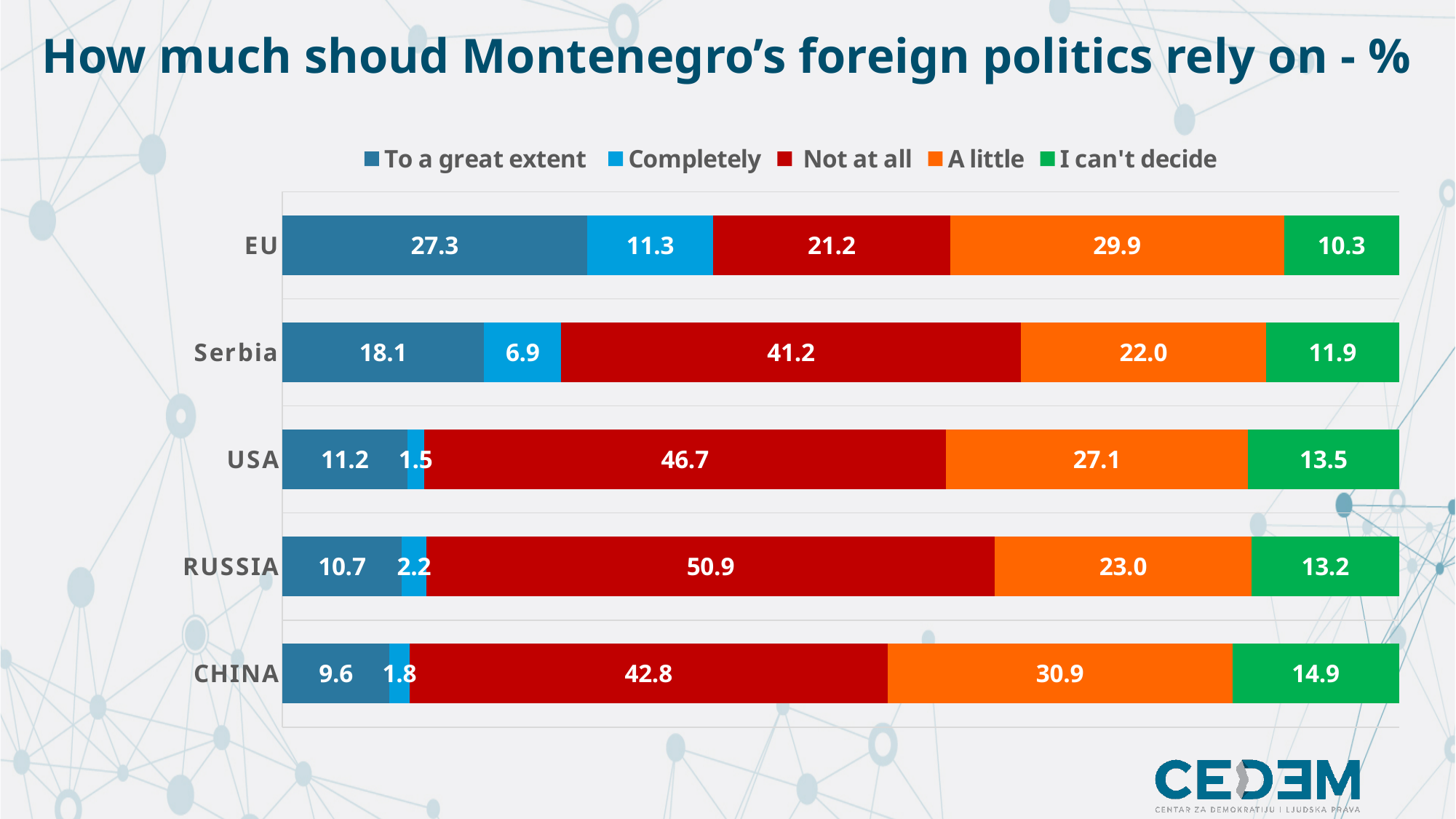
What percentage of respondents said Montenegro's foreign politics should rely on the EU "To a great extent"? 27.3 What is the difference between the "Not at all" values for RUSSIA and the EU? 29.7 Which country has the highest "Not at all" value? RUSSIA What is the total of the stacked bar for the USA? 100.0 Which country has the highest "I can't decide" value? CHINA What is the "Not at all" value for RUSSIA? 50.9 How many countries/entities are shown on the chart? 5 Which country has the lowest "To a great extent" value? CHINA Which is larger: the "Completely" value for the EU or for Serbia? EU What is the "A little" value for CHINA? 30.9 How many series does the legend list? 5 What kind of chart is shown on the slide? Stacked bar chart